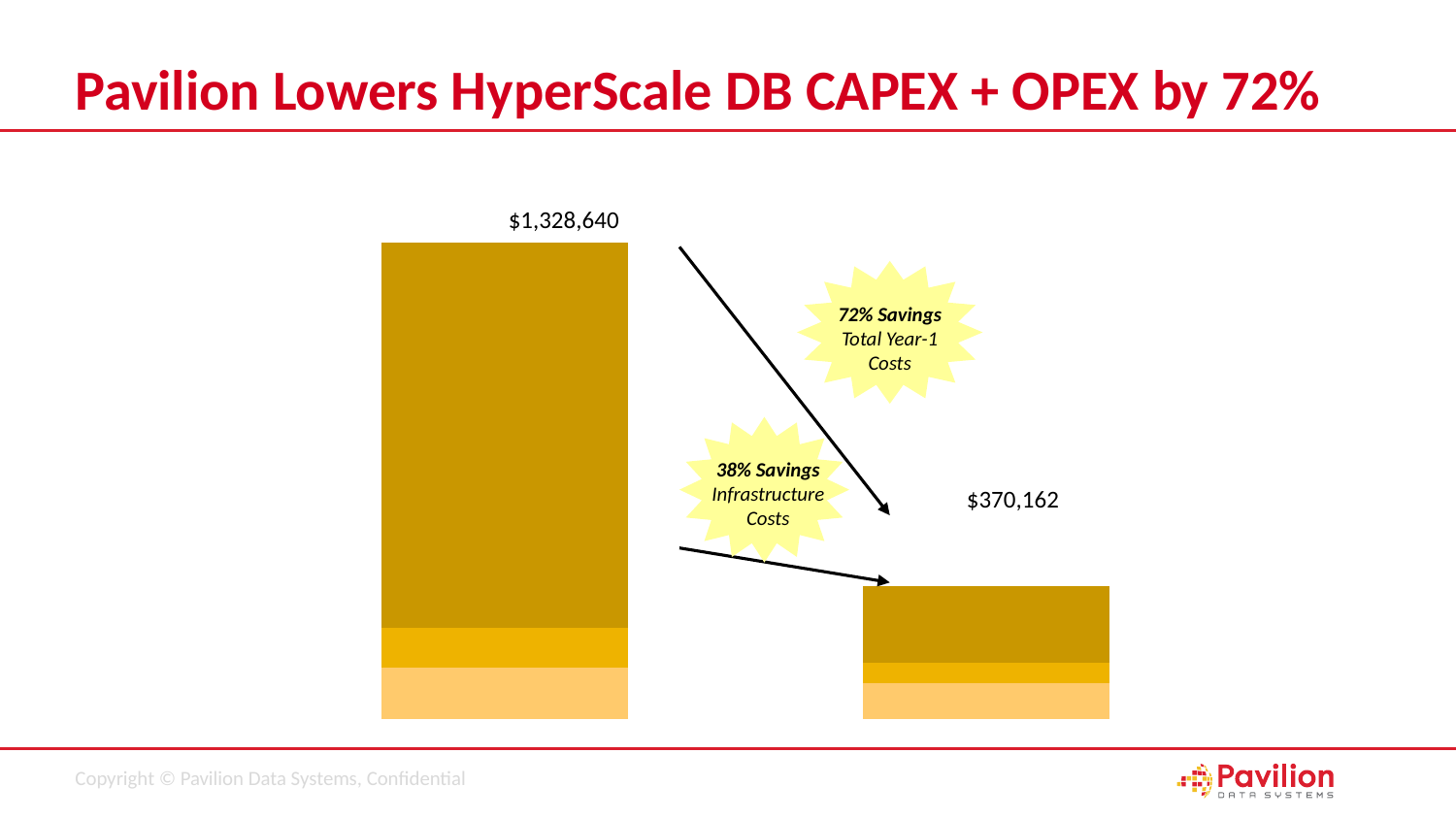
What percentage savings in Total Year-1 Costs is called out on the chart? 72% What is the total value labeled on the right bar? $370,162 What kind of chart is shown on the slide? bar chart What is the total value labeled on the left bar? $1,328,640 Which bar has the higher total, the left bar or the right bar? left bar How many bars are plotted in the chart? 2 What is the difference between the left bar's total and the right bar's total? $958,478 How many stacked segments make up each bar? 3 What percentage savings in Infrastructure Costs is called out on the chart? 38% Do the bar totals rise or fall from the left bar to the right bar? fall Which bar has the lowest total value? right bar